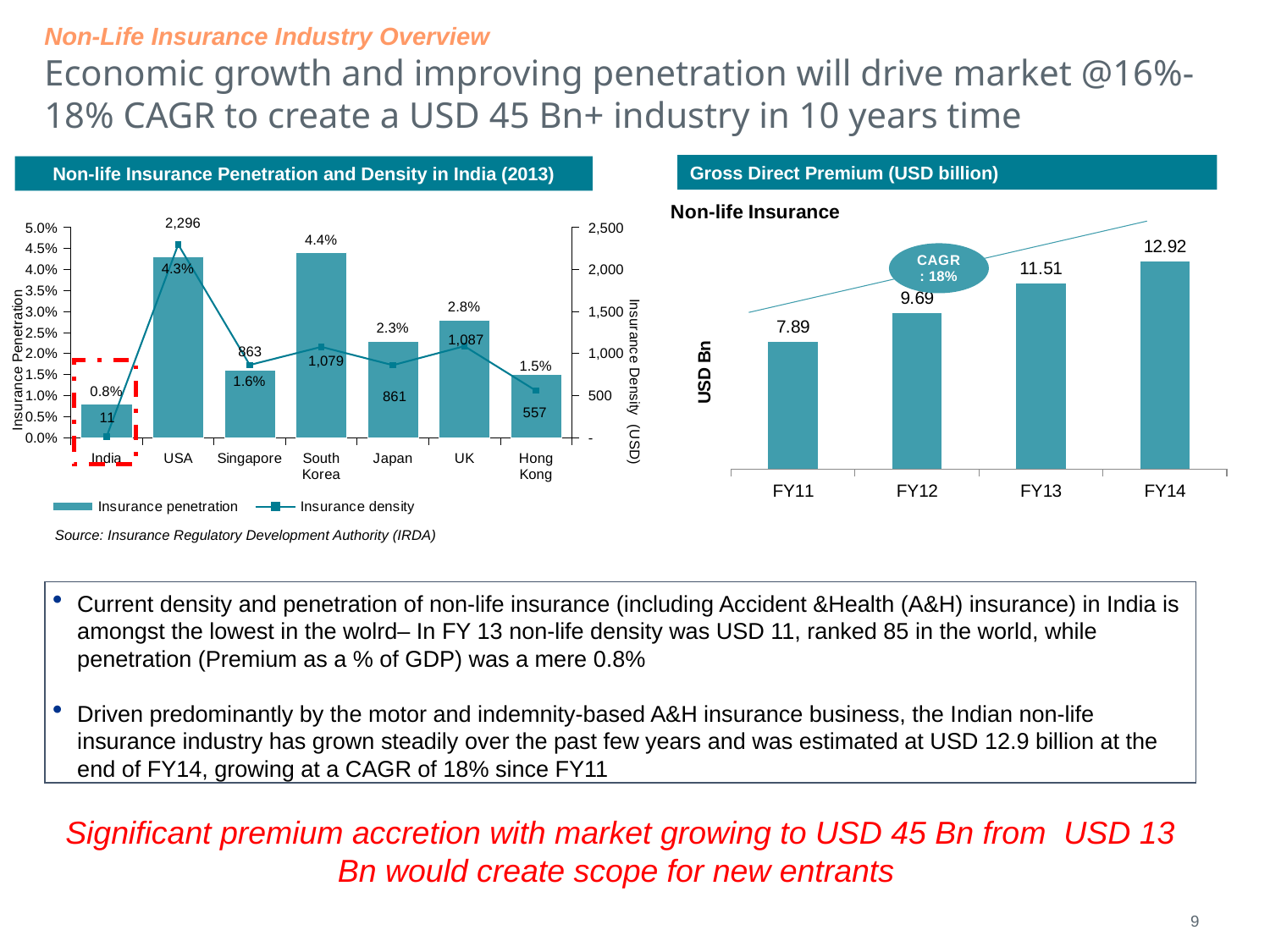
In the Non-life Insurance Penetration and Density in India (2013) chart, which country has the lowest insurance density? India In the Non-life Insurance Penetration and Density in India (2013) chart, which has the higher insurance density, Singapore or Hong Kong? Singapore What CAGR is shown in the oval on the Gross Direct Premium (USD billion) chart? 18% In the Non-life Insurance Penetration and Density in India (2013) chart, what is the insurance penetration for India? 0.8% In the Non-life Insurance Penetration and Density in India (2013) chart, how many countries are shown on the x axis? 7 In the Gross Direct Premium (USD billion) chart, what is the difference between the FY14 and FY11 values? 5.03 In the Gross Direct Premium (USD billion) chart, do the values rise or fall from FY11 to FY14? rise In the Non-life Insurance Penetration and Density in India (2013) chart, how many series does the legend list? 2 In the Non-life Insurance Penetration and Density in India (2013) chart, what is the insurance density for the USA? 2,296 In the Non-life Insurance Penetration and Density in India (2013) chart, which country has the highest insurance penetration? South Korea In the Gross Direct Premium (USD billion) chart, what is the value for FY12? 9.69 What kind of chart is the Gross Direct Premium (USD billion) chart? bar chart